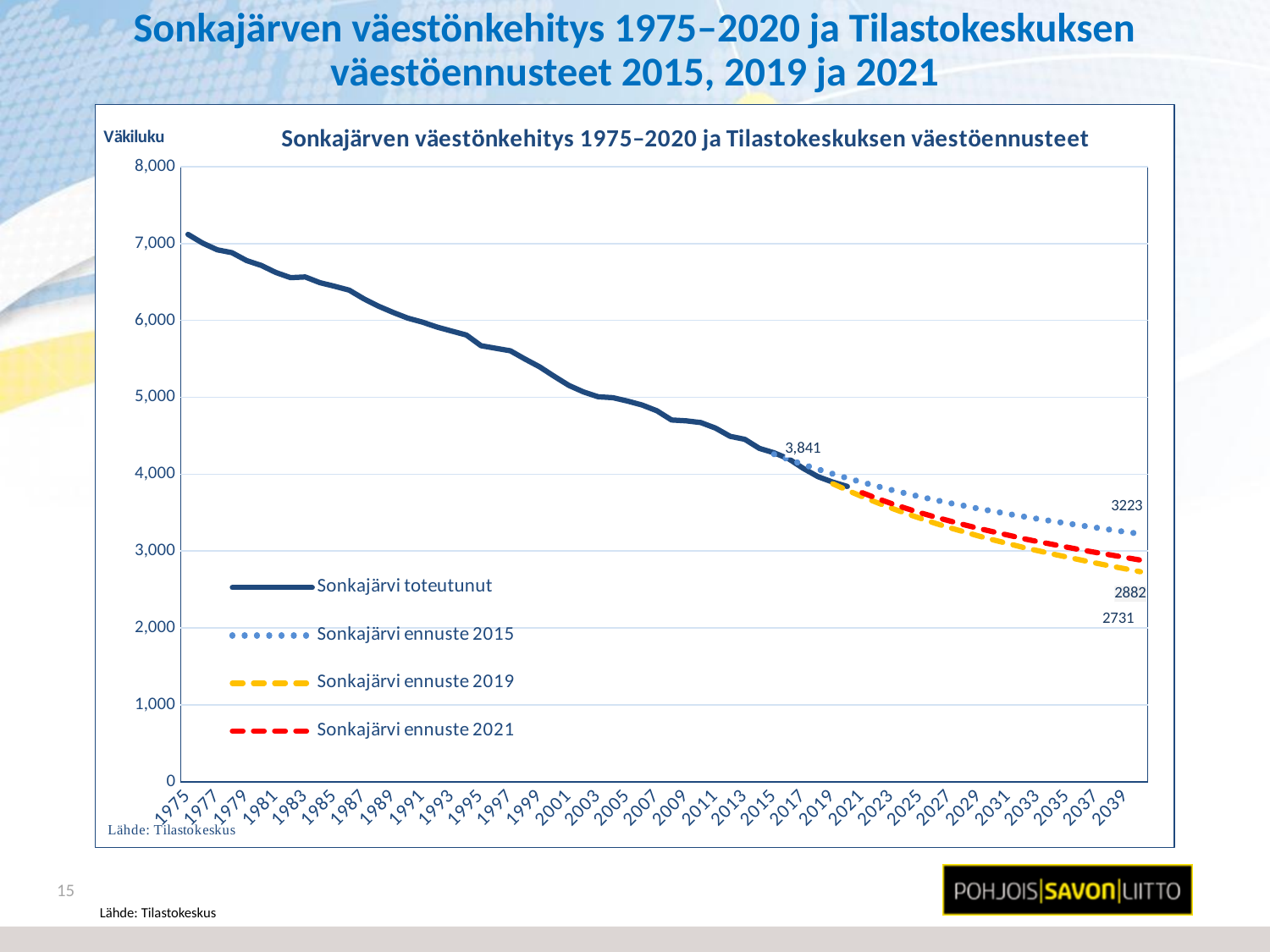
Does the Sonkajärvi toteutunut series rise or fall from 1975 to 2020? fall What is the final labelled value of the Sonkajärvi ennuste 2019 series? 2731 Which forecast series ends at the highest value in 2040? Sonkajärvi ennuste 2015 What kind of chart is shown on the slide? line chart What is the difference between the final labelled values of the ennuste 2021 and ennuste 2019 series? 151 Which forecast series ends at the lowest value in 2040? Sonkajärvi ennuste 2019 What is the final labelled value of the Sonkajärvi ennuste 2021 series? 2882 Is the value for Sonkajärvi toteutunut in 1975 greater or less than 7,000? greater What is the final labelled value of the Sonkajärvi ennuste 2015 series? 3223 How many series does the legend list? 4 What is the label on the vertical axis of the chart? Väkiluku What is the difference between the final labelled values of the ennuste 2015 and ennuste 2019 series? 492